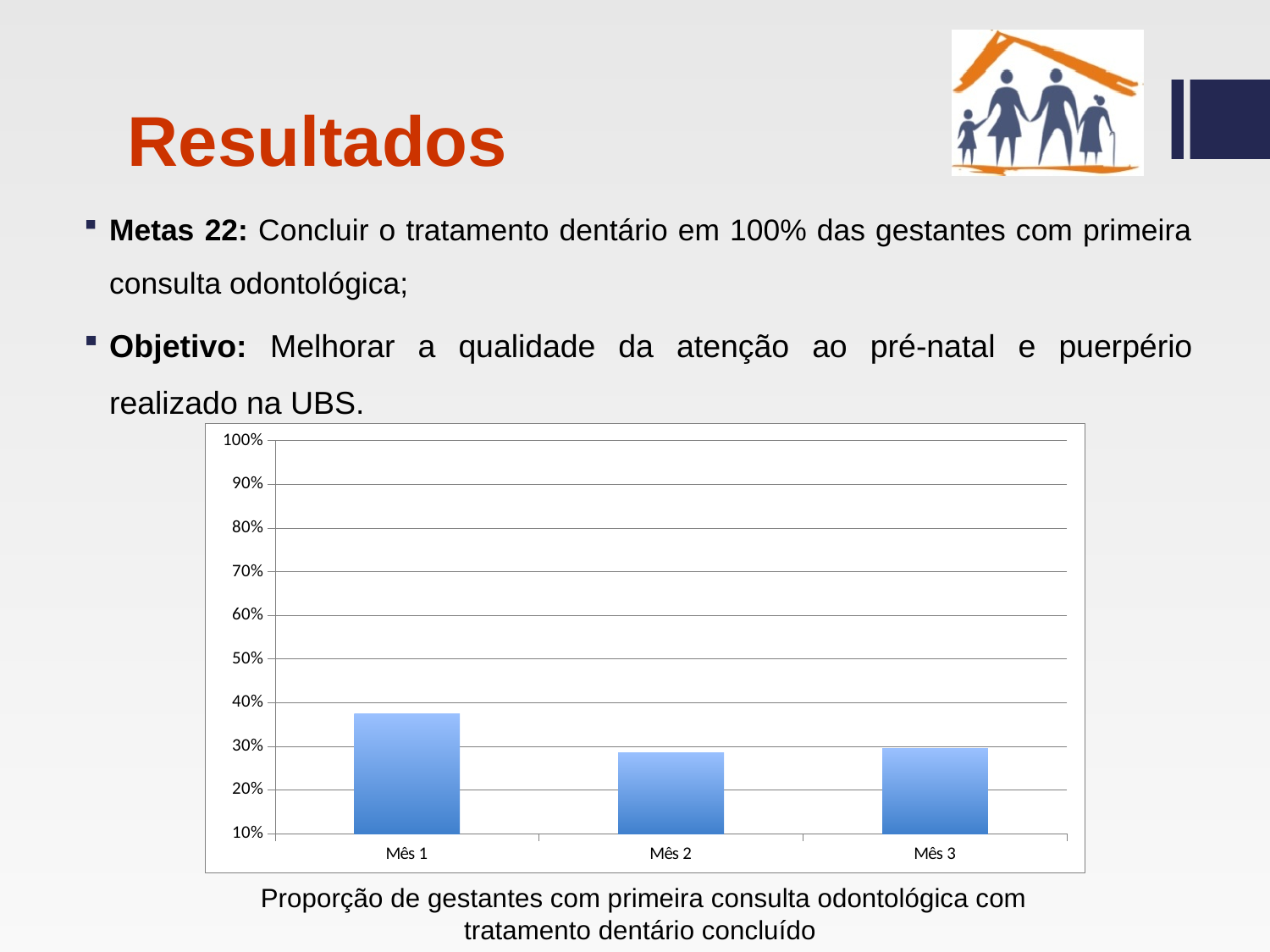
Does the value rise or fall from Mês 1 to Mês 2? fall What is the highest value shown on the chart's vertical axis? 100% Is the value for Mês 3 greater or less than 40%? less Is the value for Mês 2 greater or less than 20%? greater Is the value for Mês 1 greater or less than 40%? less How many months (categories) are plotted on the chart? 3 Which is larger, the value for Mês 1 or the value for Mês 2? Mês 1 Which month has the highest proportion on the chart? Mês 1 What kind of chart is shown on the slide? bar chart What is the caption printed below the chart? Proporção de gestantes com primeira consulta odontológica com tratamento dentário concluído Which is larger, the value for Mês 1 or the value for Mês 3? Mês 1